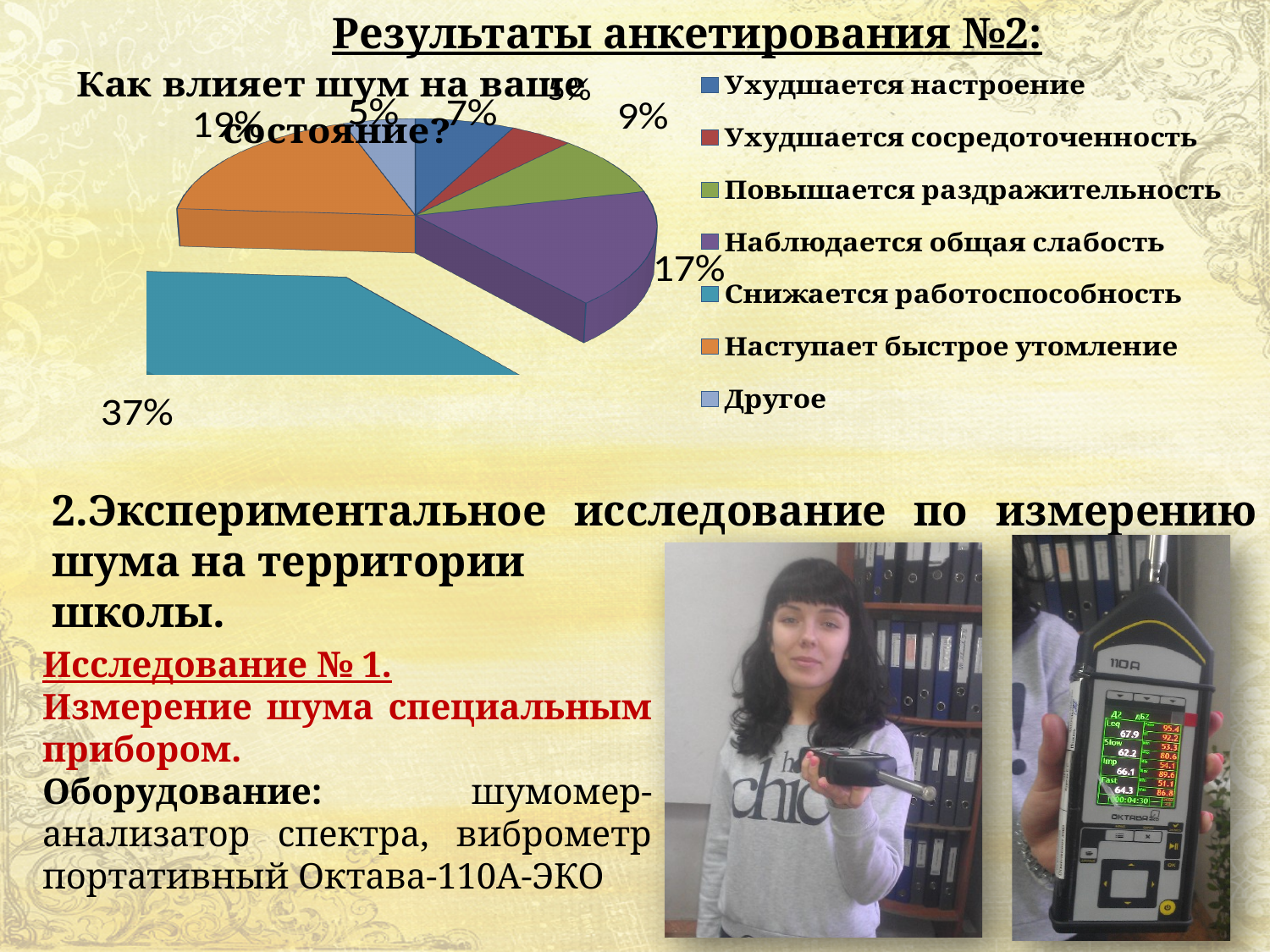
What share of the pie is labelled for "Другое"? 5% Which category has the largest slice of the pie? Снижается работоспособность What share of the pie is labelled for "Снижается работоспособность"? 37% What share of the pie is labelled for "Наступает быстрое утомление"? 19% What is the title of the pie chart? Как влияет шум на ваше состояние? What share of the pie is labelled for "Ухудшается настроение"? 7% What share of the pie is labelled for "Повышается раздражительность"? 9% What share of the pie is labelled for "Наблюдается общая слабость"? 17% What kind of chart is shown on the slide? Pie chart By how many percentage points does "Снижается работоспособность" exceed "Наступает быстрое утомление"? 18 How many categories does the pie chart legend list? 7 Which slice is larger: "Наблюдается общая слабость" or "Наступает быстрое утомление"? Наступает быстрое утомление